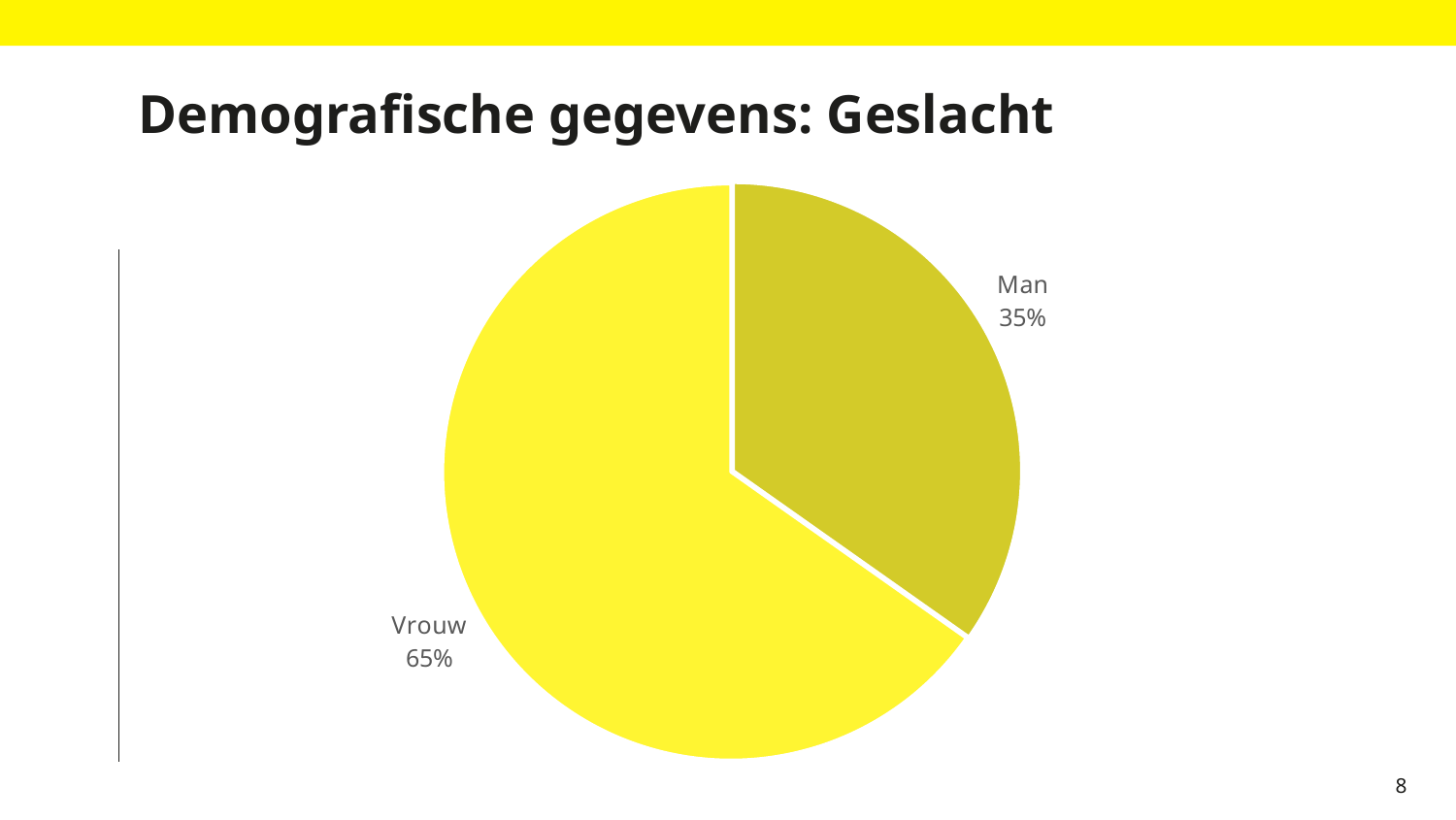
Is the share for Vrouw greater or less than 50%? greater What is the difference in percentage points between the Vrouw and Man slices? 30% What is the combined share of the Man and Vrouw slices? 100% Which slice of the pie is the largest? Vrouw What is the title of the slide containing the pie chart? Demografische gegevens: Geslacht Which slice of the pie is the smallest? Man How many slices does the pie chart have? 2 Is the share for Man greater or less than 50%? less What share of the pie is labelled Man? 35% Which is larger, the Man slice or the Vrouw slice? Vrouw What kind of chart is shown on the slide? pie chart What share of the pie is labelled Vrouw? 65%